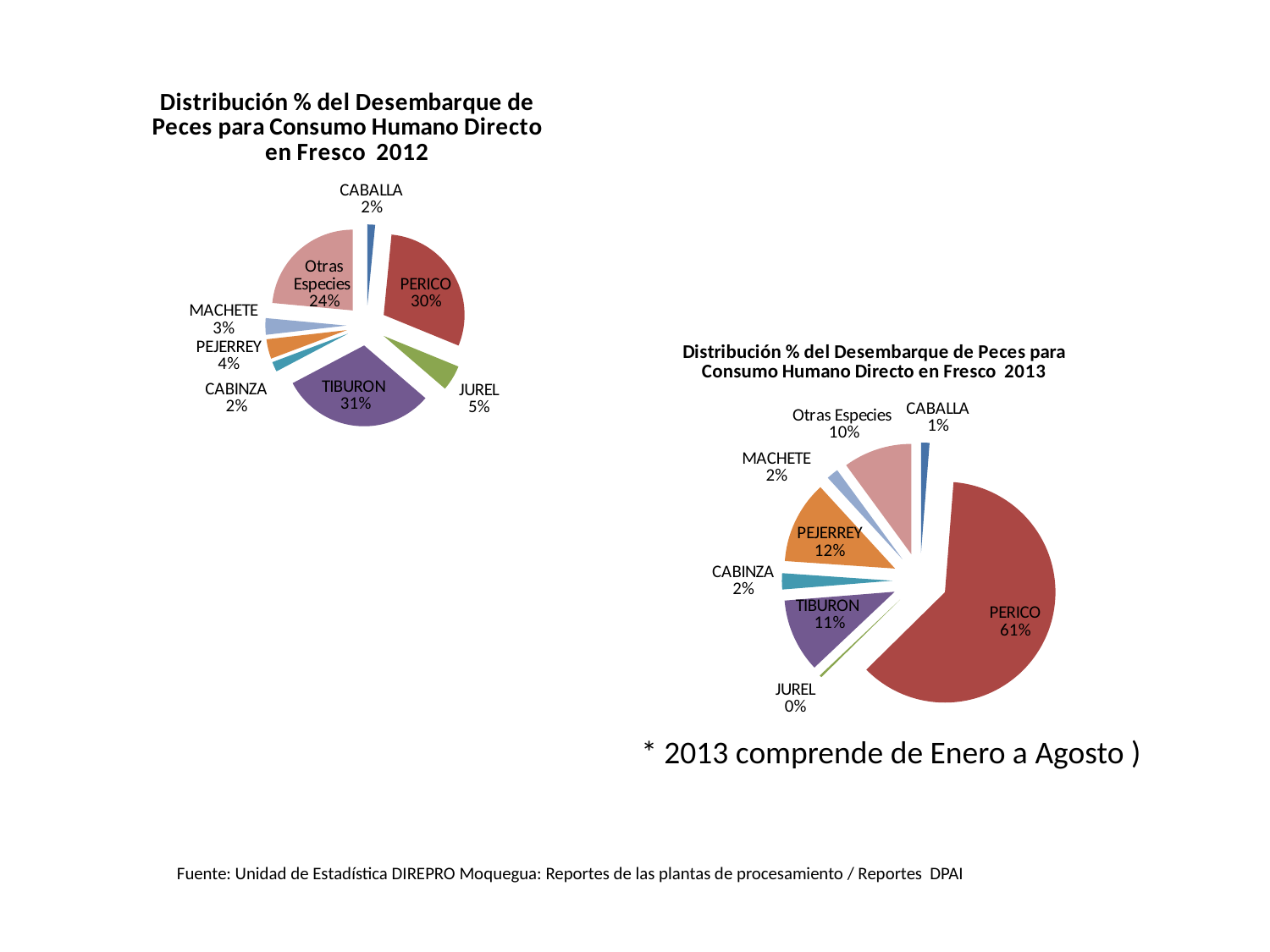
What is the title of the chart on the left? Distribución % del Desembarque de Peces para Consumo Humano Directo en Fresco 2012 In the 2013 pie chart, what share does PEJERREY have? 12% In the 2013 pie chart, what is the difference between the shares of PERICO and TIBURON? 50% What type of chart is used for the 2013 distribution? Pie chart In the 2013 pie chart, which species has the smallest share? JUREL How many slices does the 2012 pie chart have? 8 In the 2013 pie chart, which species has the largest share? PERICO In the 2012 pie chart, what share does Otras Especies have? 24% In the 2012 pie chart, what is the difference between the shares of TIBURON and Otras Especies? 7% In the 2012 pie chart, what share does PERICO have? 30% In the 2012 pie chart, which is larger, the share of JUREL or the share of PEJERREY? JUREL In the 2013 pie chart, what share does PERICO have? 61%